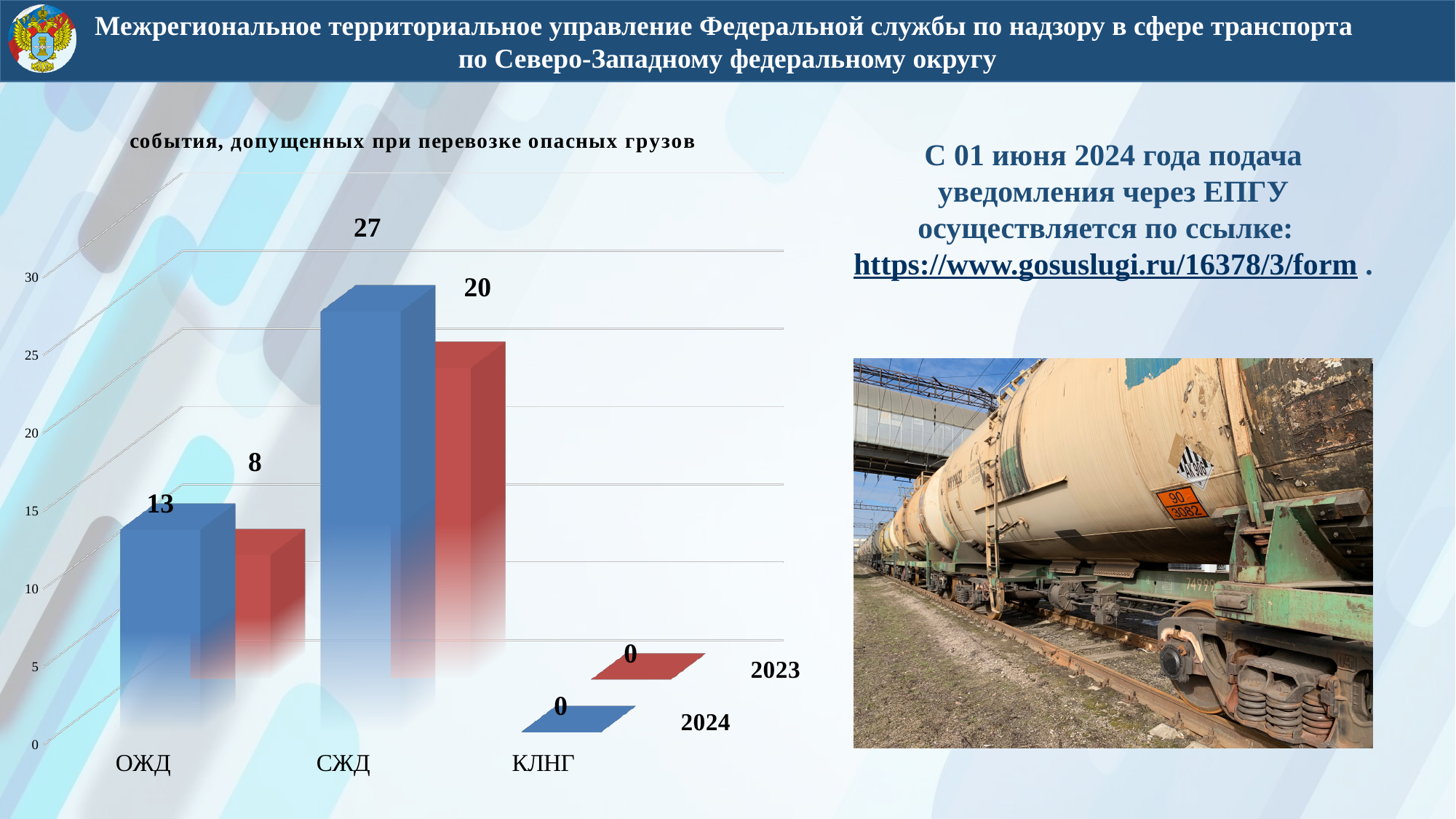
Which category has the highest value in the 2024 series? СЖД What is the value for ОЖД in the 2023 series? 8 How many series does the chart show? 2 What is the difference between the 2024 and 2023 values for ОЖД? 5 What is the difference between the 2024 and 2023 values for СЖД? 7 What is the value for ОЖД in the 2024 series? 13 What is the value for СЖД in the 2023 series? 20 What is the value for КЛНГ in the 2024 series? 0 Which category has the lowest value in the 2023 series? КЛНГ What kind of chart is shown on the slide? Bar chart Which is larger for ОЖД: the 2024 value or the 2023 value? 2024 How many categories are shown on the x axis? 3